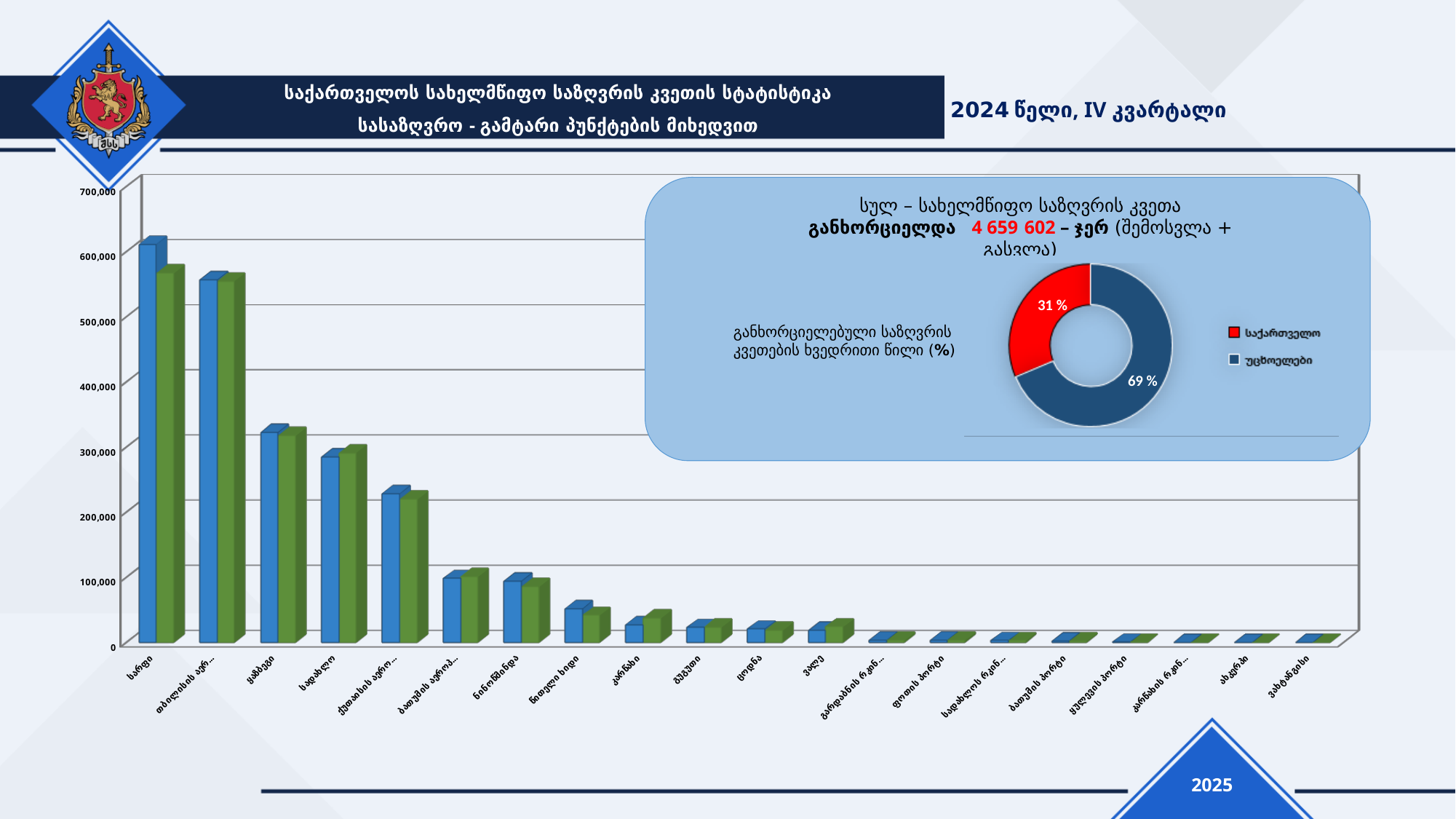
In the bar chart on the left, do the values generally rise or fall moving from left to right along the x axis? fall In the bar chart on the left, is the blue value for ყაზბეგი greater or less than 400,000? less In the bar chart on the left, which category has the highest values? სარფი In the bar chart on the left, is the blue value for სადახლო greater or less than 200,000? greater In the donut chart on the right, which slice is larger, საქართველო or უცხოელები? უცხოელები In the donut chart on the right, what share is shown for საქართველო? 31 % In the bar chart on the left, is the blue value for ნინოწმინდა greater or less than 200,000? less In the donut chart on the right, what share is shown for უცხოელები? 69 % How many categories are shown along the x axis of the bar chart on the left? 20 How many entries does the legend of the donut chart on the right list? 2 What type of chart is the large chart on the left of the slide? bar chart